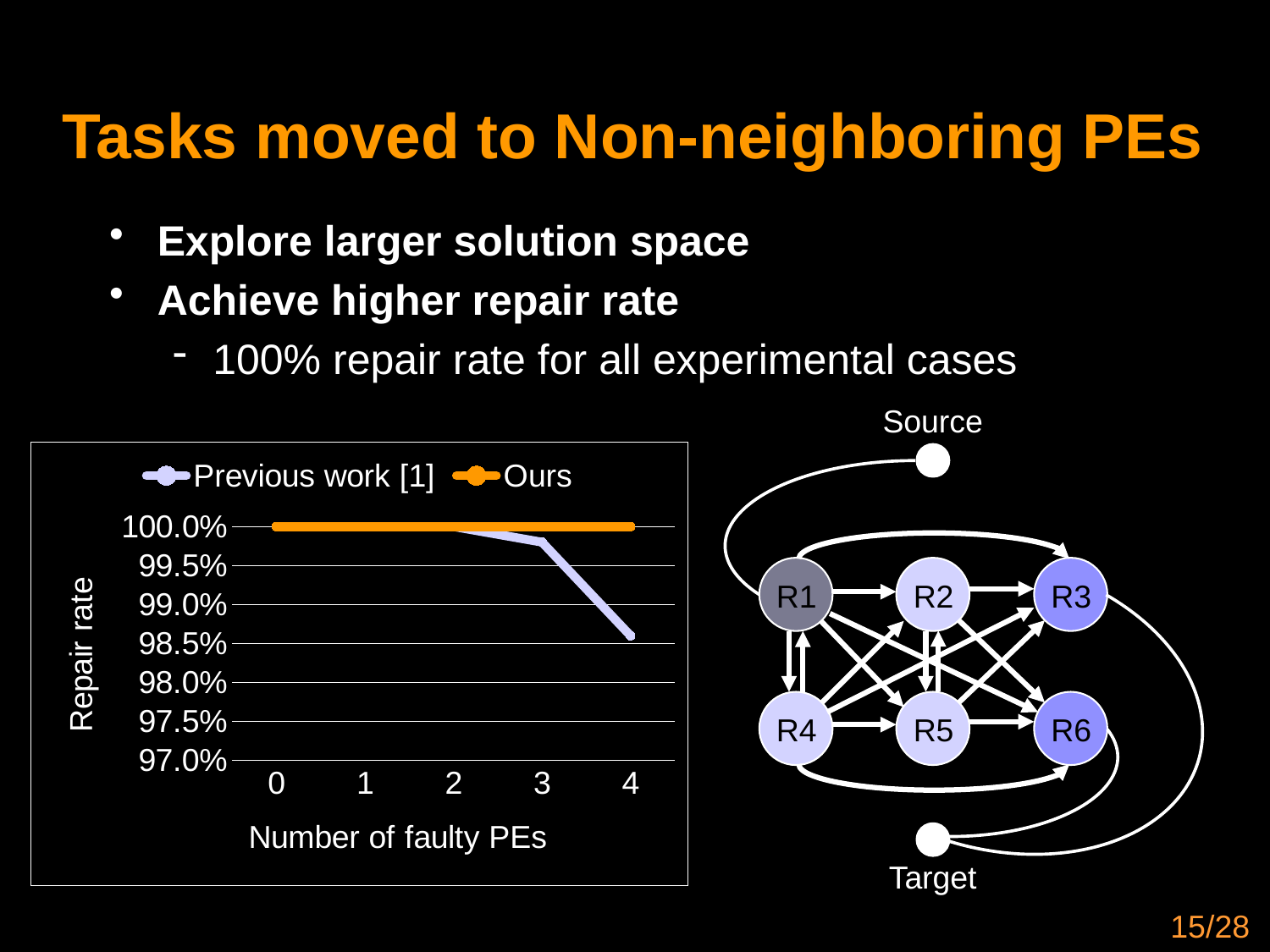
Does the repair rate for Ours rise, fall, or stay flat across the number of faulty PEs? stay flat What kind of chart is shown on the slide? line chart At 4 faulty PEs, which series has the higher repair rate, Previous work [1] or Ours? Ours Is the repair rate for Previous work [1] at 4 faulty PEs greater or less than 99.0%? less Is the repair rate for Previous work [1] at 3 faulty PEs greater or less than 99.5%? greater What is the repair rate for Previous work [1] at 0 faulty PEs? 100.0% What is the repair rate for Ours at 4 faulty PEs? 100.0% How many values of the number of faulty PEs are shown on the x axis? 5 At which number of faulty PEs is the repair rate for Previous work [1] lowest? 4 Does the repair rate for Previous work [1] rise, fall, or stay flat as the number of faulty PEs increases from 2 to 4? fall What are the two series named in the chart's legend? Previous work [1] and Ours How many series does the chart's legend list? 2